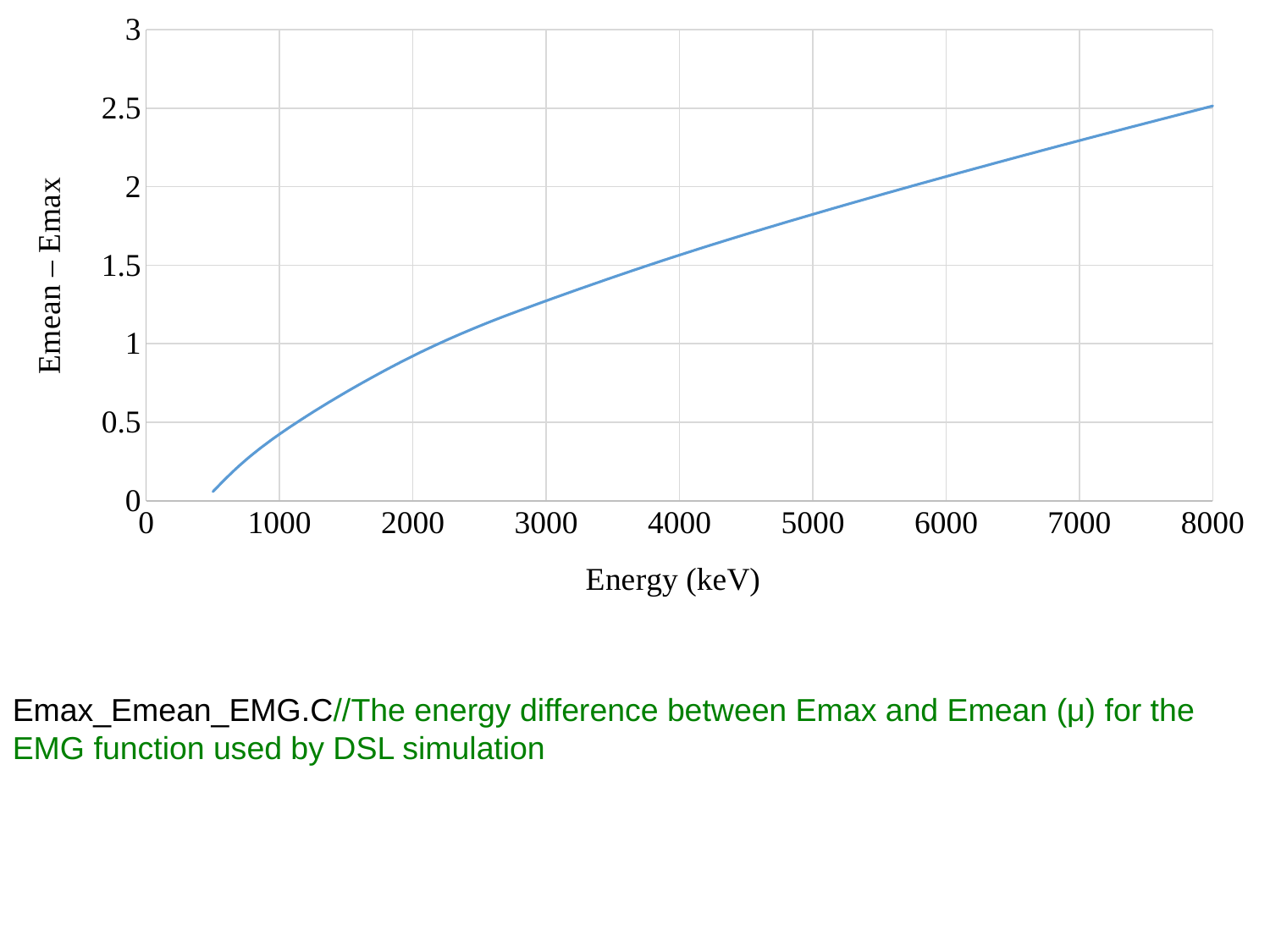
Is the value of Emean – Emax at 3000 keV greater or less than 1? greater Is the value of Emean – Emax at 7000 keV greater or less than 2? greater Is the value of Emean – Emax at 5000 keV greater or less than 2? less Does the plotted value rise or fall as Energy (keV) increases along the x axis? rise What is the label of the y axis? Emean – Emax What kind of chart is shown on the slide? line chart Is the value of Emean – Emax higher at 6000 keV or at 2000 keV? 6000 keV What is the label of the x axis? Energy (keV)